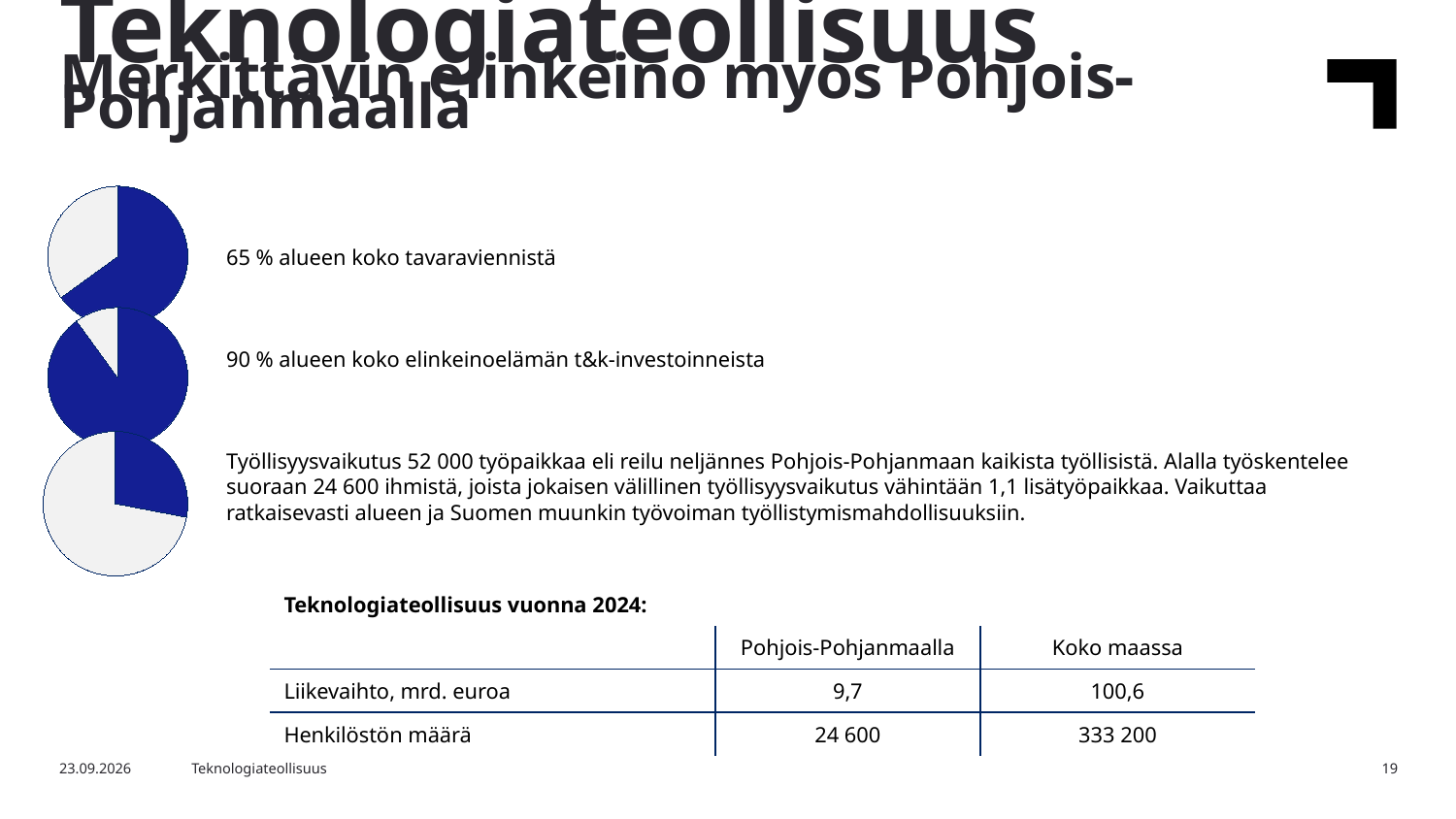
How many pie charts are on the slide? 3 Which of the three pie charts has the largest blue slice? The middle one (90 % of R&D investments) What share of the region's total goods exports does the top pie chart represent, according to the text beside it? 65 % Which of the three pie charts has the smallest blue slice? The bottom one (employment effect) What share of the region's business R&D investments does the middle pie chart represent, according to the text beside it? 90 % According to the text next to the bottom pie chart, roughly what fraction of all employed people in Pohjois-Pohjanmaa does the blue slice represent? Just over a quarter (reilu neljännes) Is the blue slice in the middle pie chart greater or less than 75%? greater What kind of charts are shown on the left side of the slide? Pie charts What is the difference between the share shown for the middle pie chart and the share shown for the top pie chart? 25 percentage points Is the blue slice in the bottom pie chart greater or less than 50%? less Which is larger: the blue share in the top pie chart or in the middle pie chart? The middle pie chart What two colours are used for the slices in the pie charts? Blue and light grey